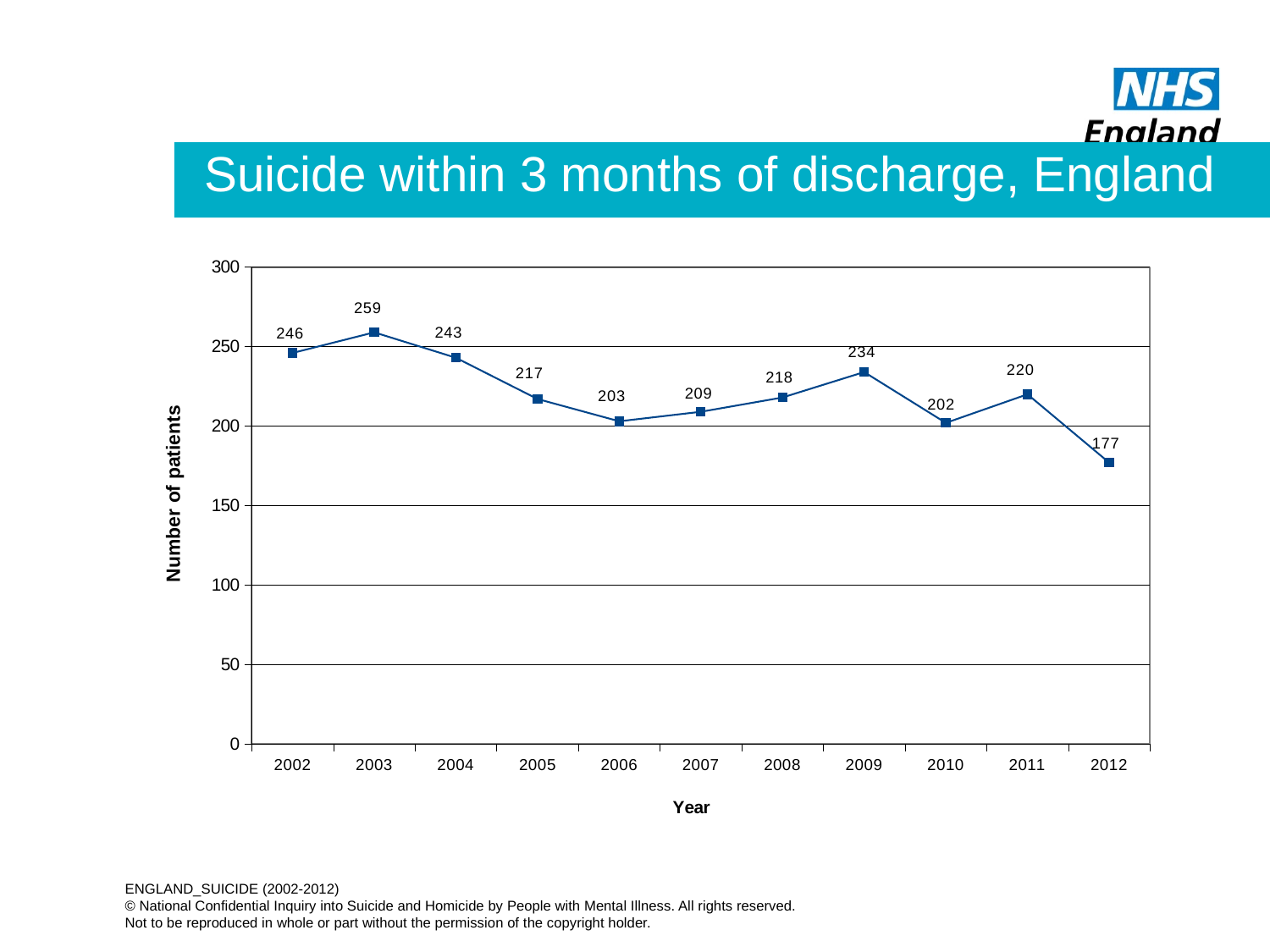
What kind of chart is shown on the slide? Line chart What is the title of the chart? Suicide within 3 months of discharge, England Is the value for 2006 greater or less than 250? less Which year has the highest number of patients? 2003 What is the number of patients for 2003? 259 What is the number of patients for 2008? 218 How many years are plotted on the chart? 11 What is the difference between the number of patients in 2009 and 2010? 32 What is the difference between the number of patients in 2003 and 2012? 82 Which year has the lowest number of patients? 2012 Which year has more patients, 2004 or 2011? 2004 What is the number of patients for 2012? 177